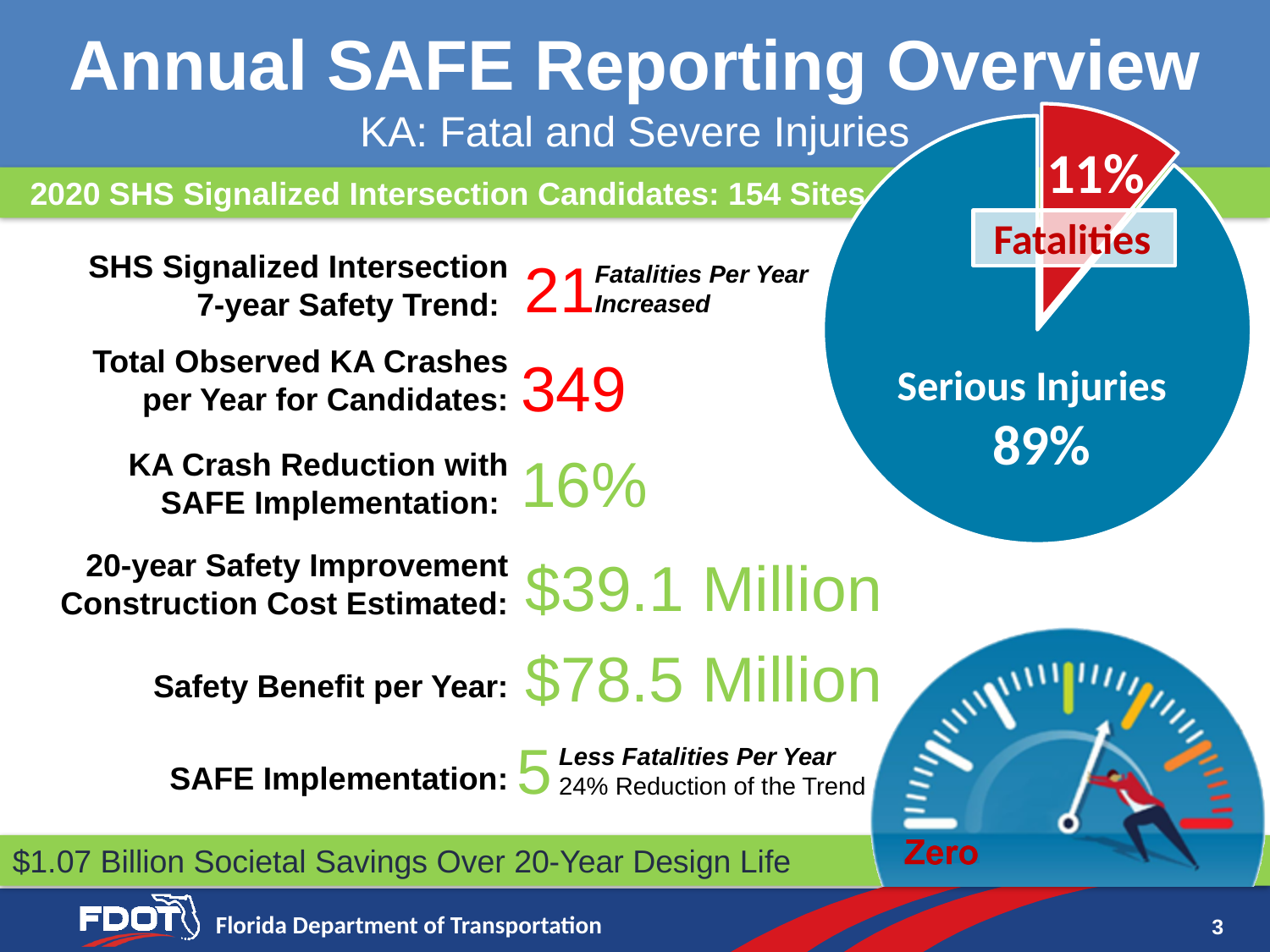
By how many percentage points does the Serious Injuries slice exceed the Fatalities slice? 78 percentage points Which is larger in the pie chart, Fatalities or Serious Injuries? Serious Injuries What colour is the Serious Injuries slice in the pie chart? Blue What percentage of the pie chart is Fatalities? 11% Which slice of the pie chart is the smallest? Fatalities What share of the pie does the Fatalities slice represent? 11% How many slices does the pie chart have? 2 What percentage of the pie chart is Serious Injuries? 89% Which slice of the pie chart is the largest? Serious Injuries What colour is the Fatalities slice in the pie chart? Red What kind of chart is shown on the slide? Pie chart